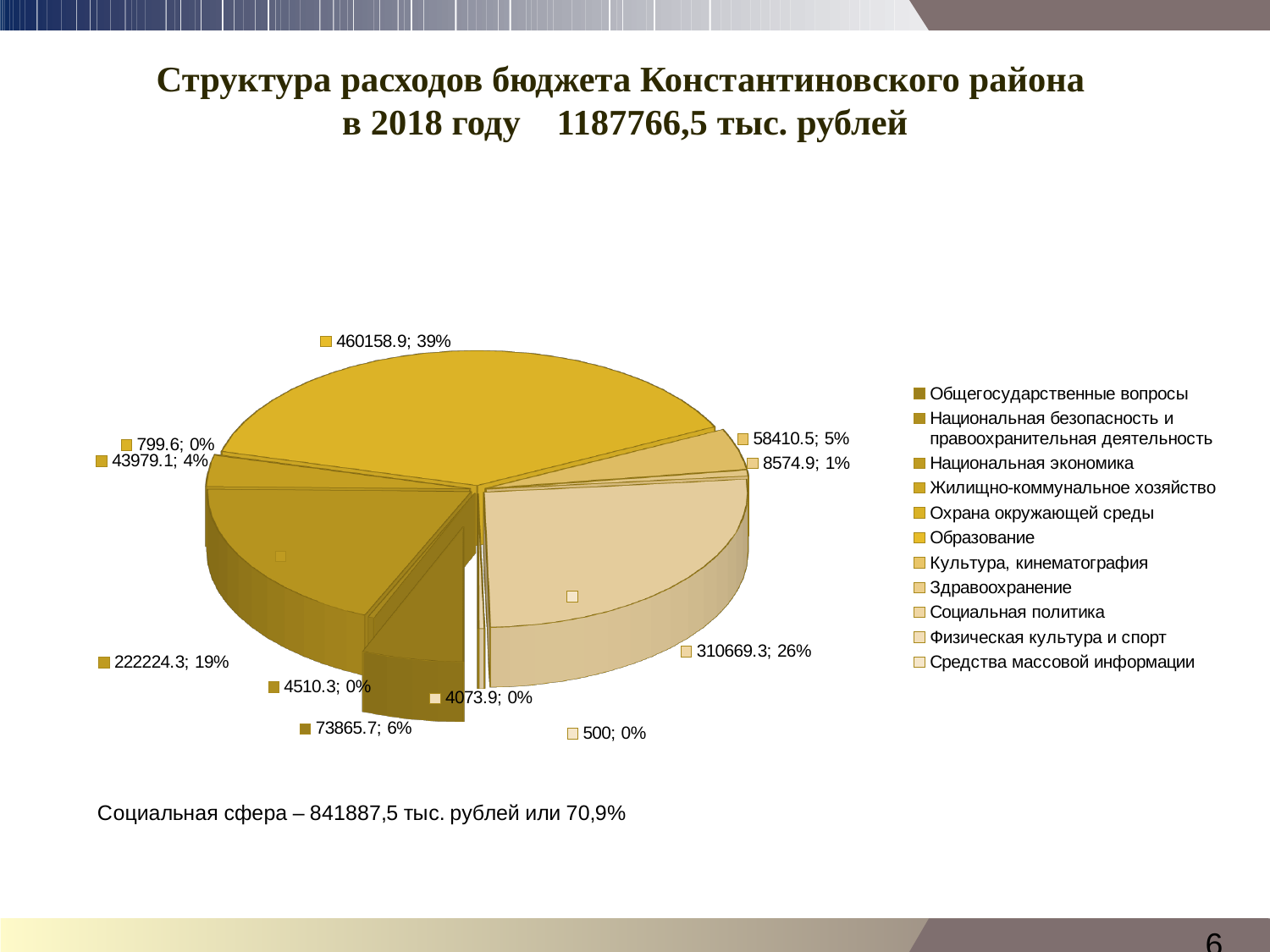
What percentage share is shown for the slice labelled 222224.3? 19% What percentage share is shown for the largest slice of the pie chart? 39% How many categories does the legend of the pie chart list? 11 What is the title of the chart on the slide? Структура расходов бюджета Константиновского района в 2018 году 1187766,5 тыс. рублей What percentage share is shown for the slice labelled 43979.1? 4% Which slice is larger: the one labelled 73865.7 or the one labelled 58410.5? 73865.7 What is the last category listed in the legend of the pie chart? Средства массовой информации What is the value of the smallest slice of the pie chart? 500 What kind of chart is shown on the slide? pie chart What is the value of the largest slice of the pie chart? 460158.9 What is the difference between the slice labelled 460158.9 and the slice labelled 310669.3? 149489.6